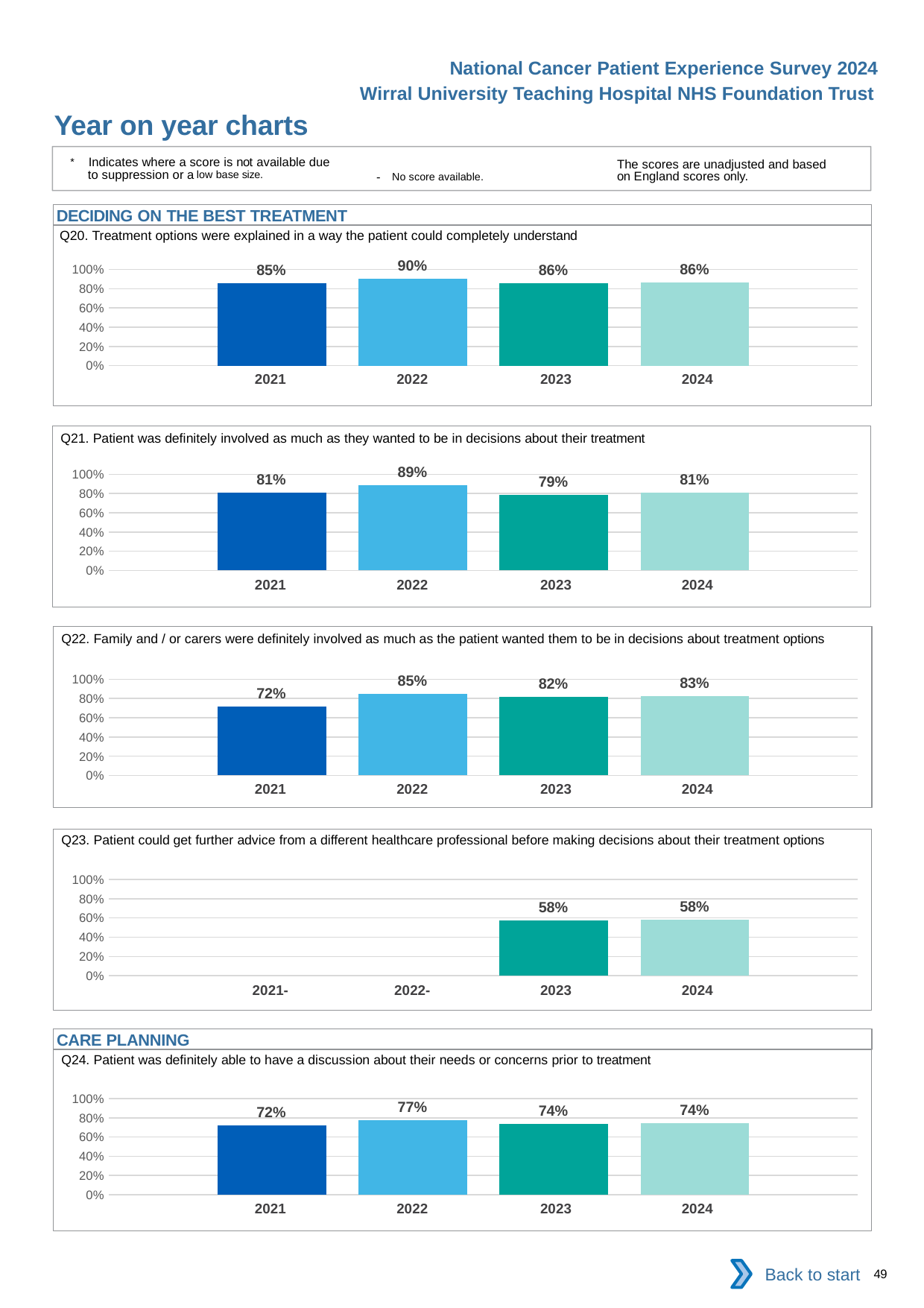
What kind of chart is the Q20 chart? bar chart In the Q21 chart, is the value for 2022 larger or smaller than the value for 2024? larger In the Q23 chart, what is the value for 2024? 58% In the Q22 chart, what is the difference between the 2022 and 2021 values? 13% In the Q24 chart, what is the difference between the 2022 and 2023 values? 3% In the Q22 chart, is the value for 2021 greater or less than 80%? less In the Q20 chart, how many years are shown on the x axis? 4 In the Q23 chart, how many years have a bar plotted? 2 Which section heading appears above the Q24 chart? CARE PLANNING In the Q20 chart, what is the value for 2022? 90% In the Q21 chart, which year has the lowest value? 2023 In the Q24 chart, which year has the highest value? 2022